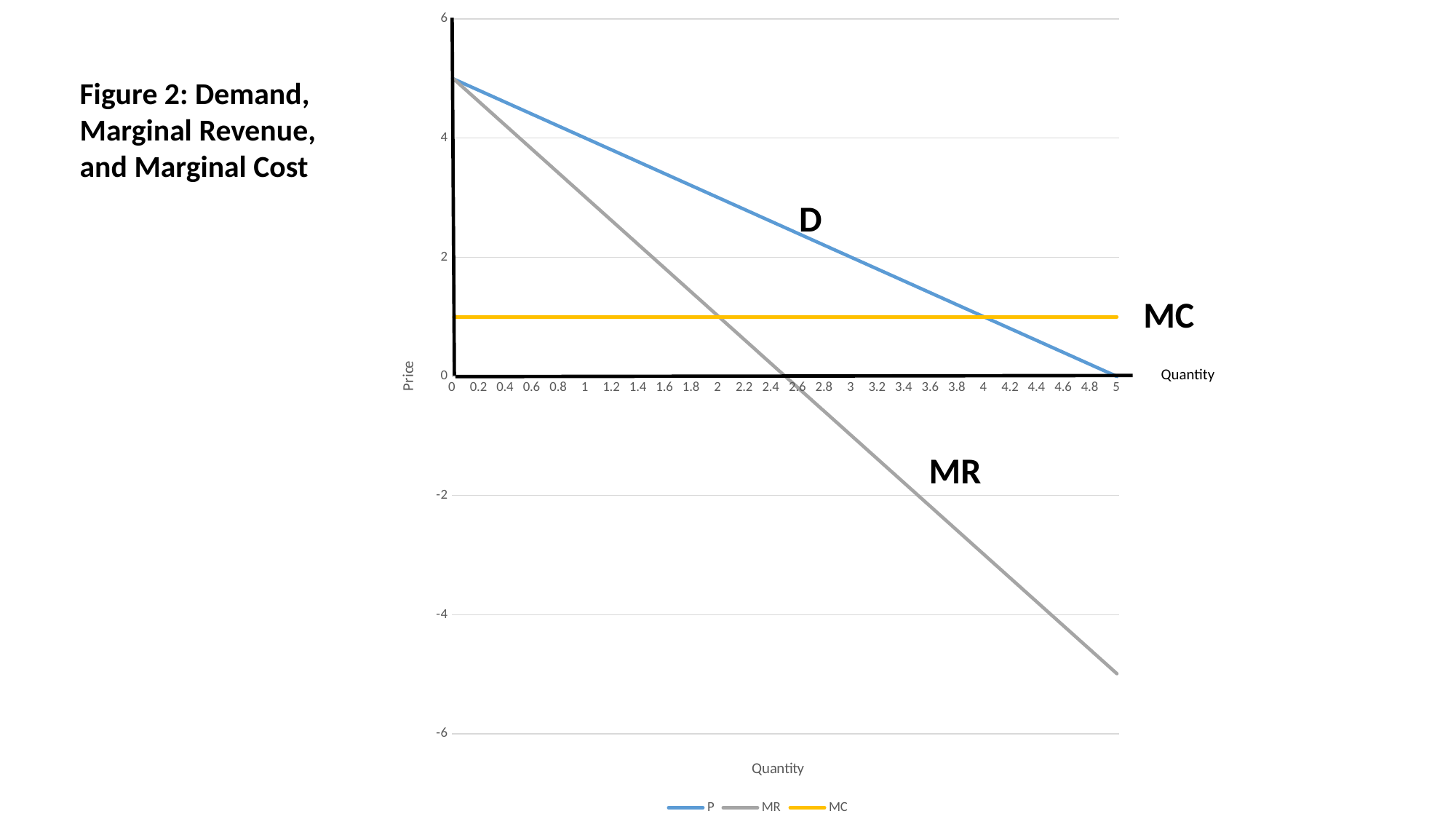
Does the MR line rise or fall as quantity increases? fall Is the value of the MC line greater or less than 2? less At quantity 3, which line has the higher value, D or MR? D What kind of chart is shown on the slide? line chart What are the series names listed in the legend? P, MR, MC Is the value of the D line at quantity 0 greater or less than 4? greater Is the value of the MC line greater or less than 0? greater What is the value of the D (P) line at quantity 5? 0 How many series does the legend list? 3 What is the title of the figure on the slide? Figure 2: Demand, Marginal Revenue, and Marginal Cost